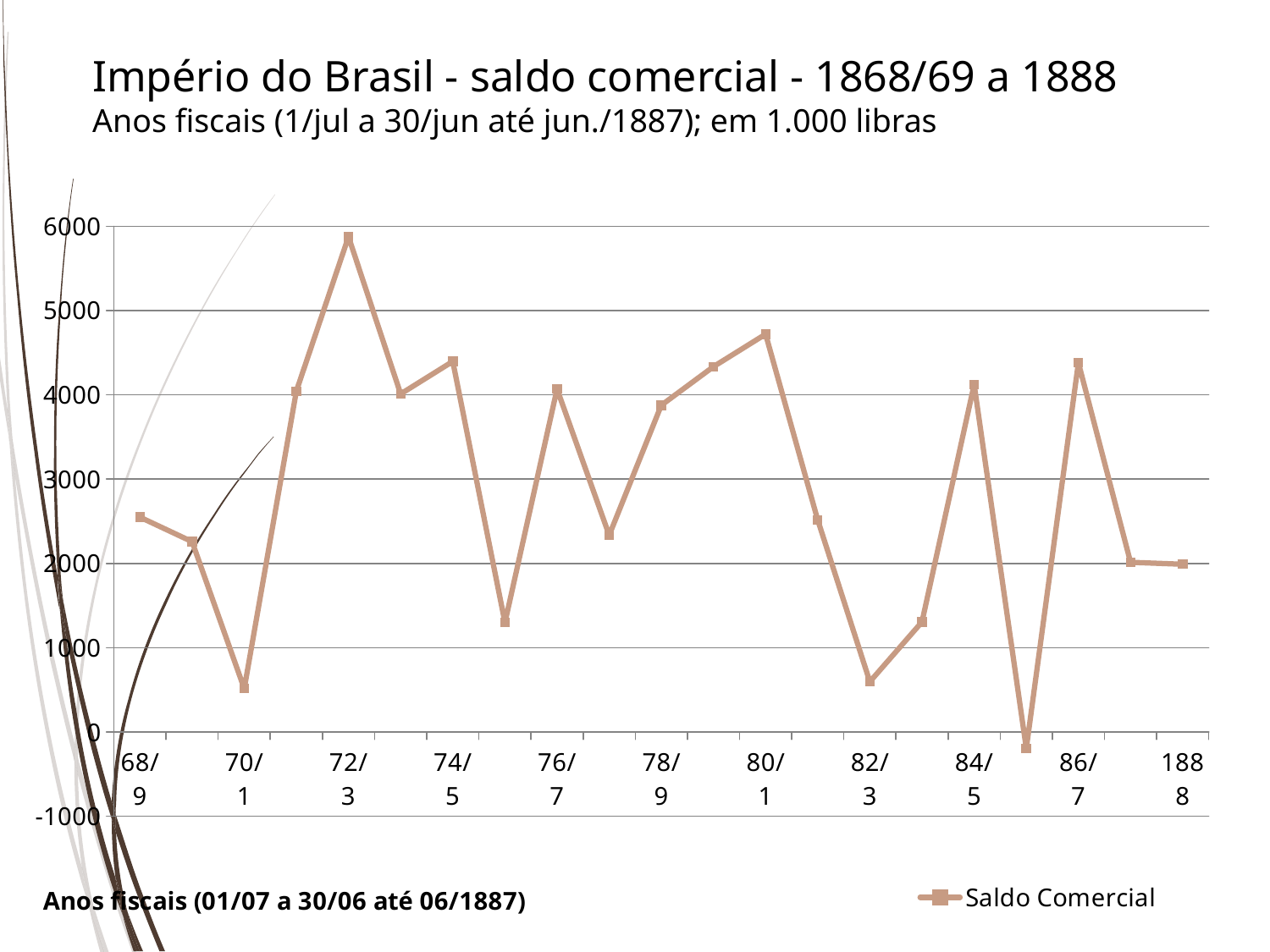
Which is larger, the value for 68/9 or the value for 70/1? 68/9 How many labelled categories are shown on the x axis? 11 Does the Saldo Comercial value rise or fall from 68/9 to 70/1? fall Is the value for 70/1 greater or less than 1000? less What is the name of the series shown in the legend? Saldo Comercial How many series does the legend list? 1 Is the value for 74/5 greater or less than 4000? greater Is the value for 72/3 greater or less than 5000? greater What kind of chart is shown on the slide? line chart Which labelled fiscal year has the highest Saldo Comercial value? 72/3